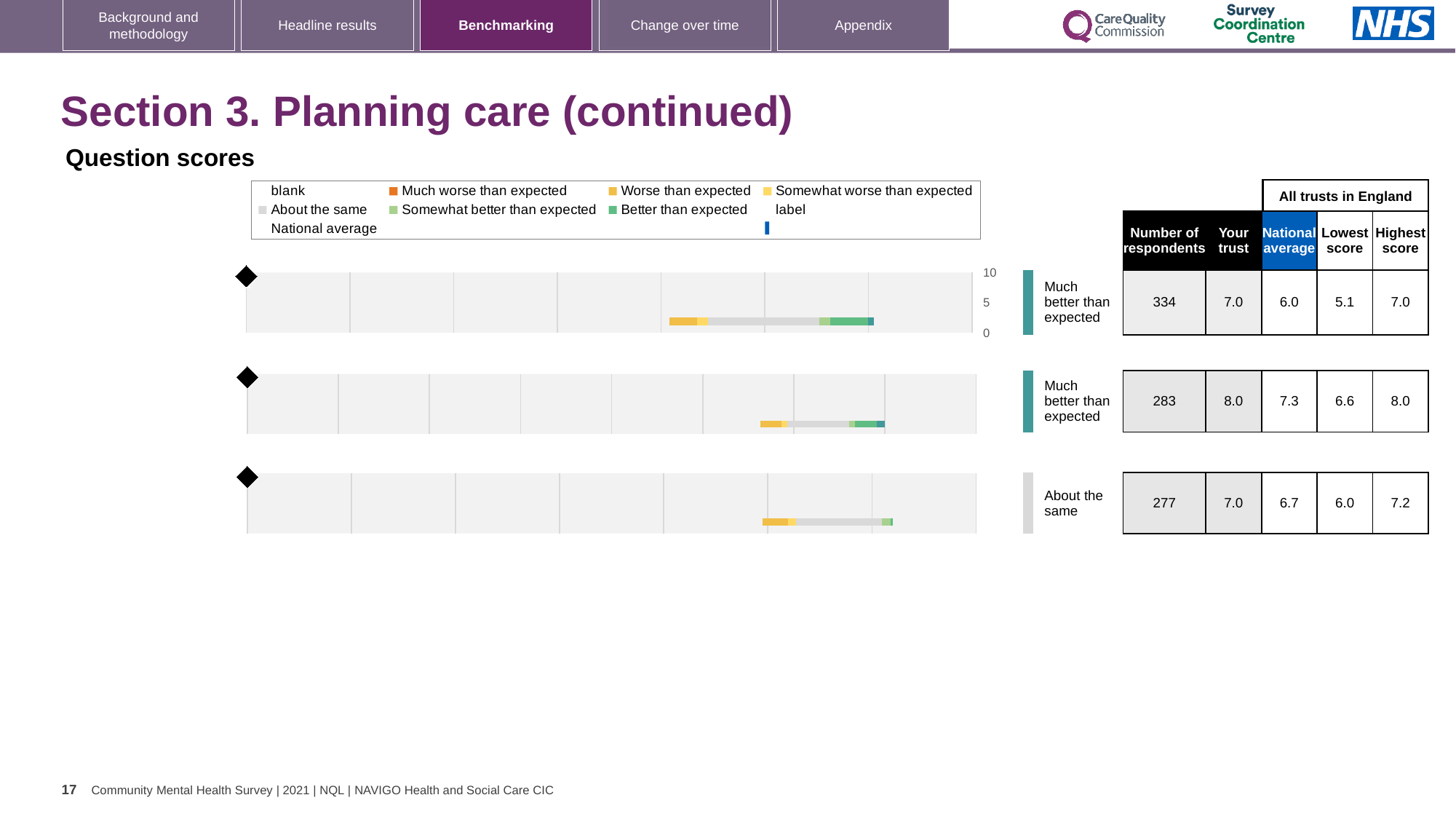
Which chart (top, middle or bottom) has the highest 'Your trust' score? middle chart What benchmark category label is shown next to the middle chart? Much better than expected For the bottom chart, what is the highest score shown in the table? 7.2 For the top chart, what is the 'Your trust' score shown in the table? 7.0 For the middle chart, which is larger: the 'Your trust' score or the national average? Your trust What benchmark category label is shown next to the bottom chart? About the same For the top chart, what is the national average shown in the table? 6.0 For the top chart, what is the difference between the highest score and the lowest score in the table? 1.9 How many charts are shown on the slide? 3 Which chart (top, middle or bottom) has the lowest number of respondents? bottom chart What kind of chart is the top chart on the slide? bar chart For the middle chart, what is the number of respondents shown in the table? 283